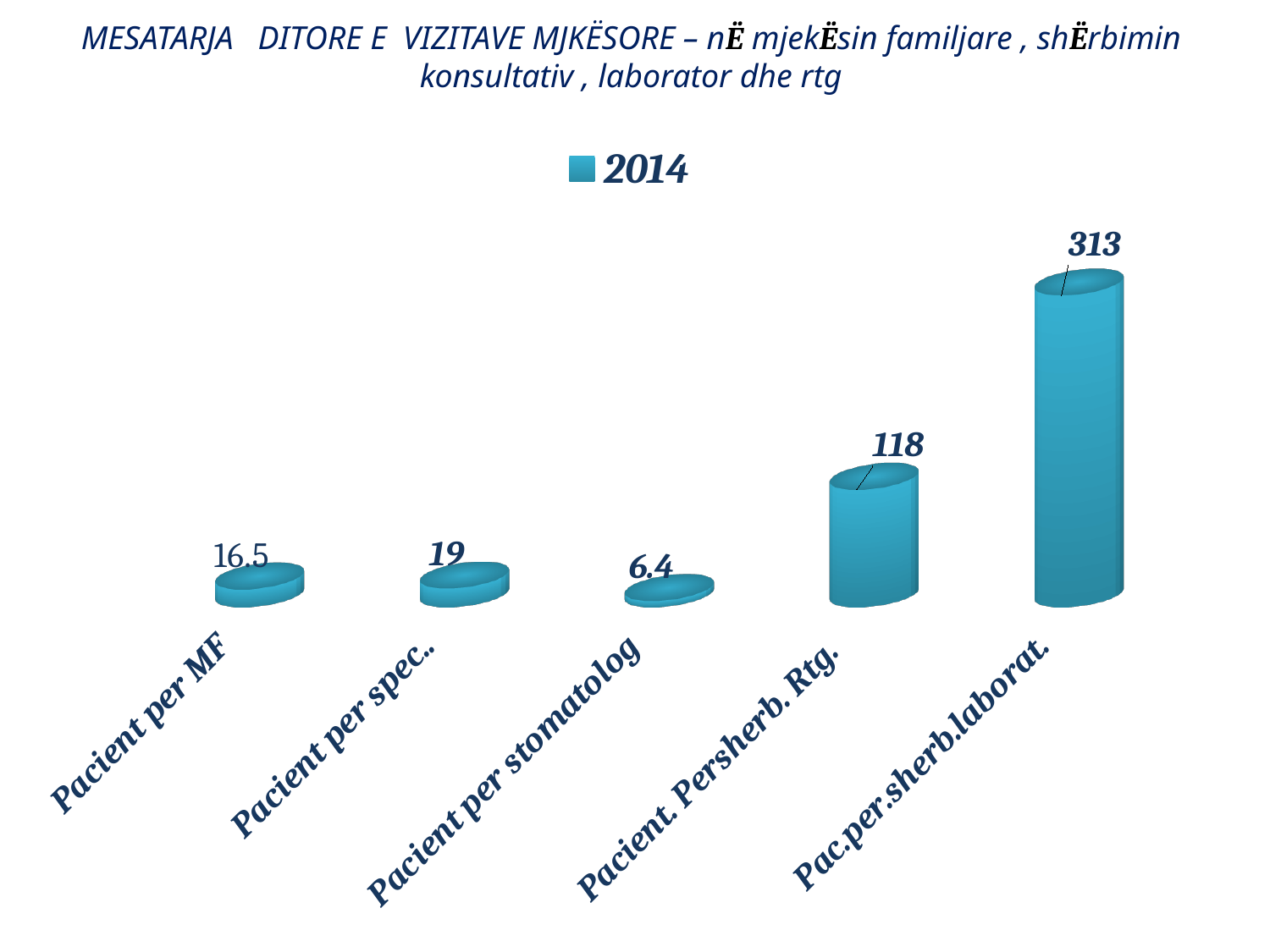
What is the value for Pac.per.sherb.laborat.? 313 What is the value for Pacient per MF? 16.5 What is the difference between the values for Pac.per.sherb.laborat. and Pacient Persherb. Rtg.? 195 What year does the legend entry show? 2014 What is the value for Pacient per spec.? 19 What is the value for Pacient Persherb. Rtg.? 118 What is the value for Pacient per stomatolog? 6.4 Which category has the highest value? Pac.per.sherb.laborat. Which category has the lowest value? Pacient per stomatolog How many categories are shown in the chart? 5 Which is larger, the value for Pacient per MF or the value for Pacient per spec.? Pacient per spec. How many series does the legend list? 1